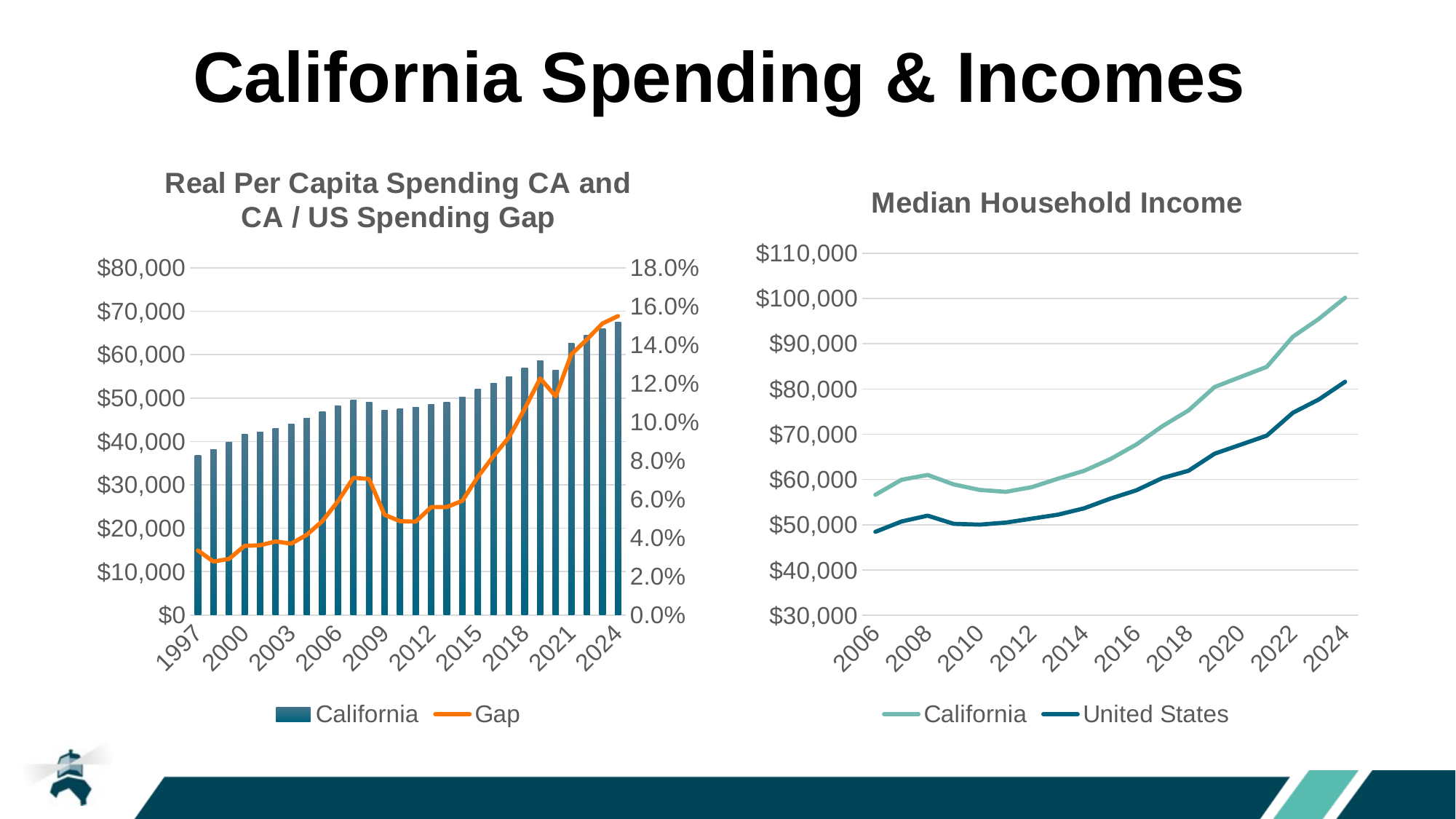
What kind of chart is the 'Real Per Capita Spending CA and CA / US Spending Gap' chart? A bar chart combined with a line chart In the 'Median Household Income' chart, how many years are plotted for each series? 19 In the 'Real Per Capita Spending CA and CA / US Spending Gap' chart, how many years (bars) are plotted? 28 In the 'Median Household Income' chart, does the United States series generally rise or fall from 2010 to 2024? Rise In the 'Real Per Capita Spending CA and CA / US Spending Gap' chart, is the California spending value for 2024 greater or less than $60,000? greater In the 'Median Household Income' chart, is the California value for 2024 greater or less than $90,000? greater In the 'Real Per Capita Spending CA and CA / US Spending Gap' chart, is the Gap value for 2024 greater or less than 14.0%? greater How many series does the legend of the 'Median Household Income' chart list? 2 In the 'Median Household Income' chart, which series has the higher value in 2024, California or United States? California In the 'Real Per Capita Spending CA and CA / US Spending Gap' chart, which series is drawn as a line? Gap What kind of chart is the 'Median Household Income' chart? Line chart